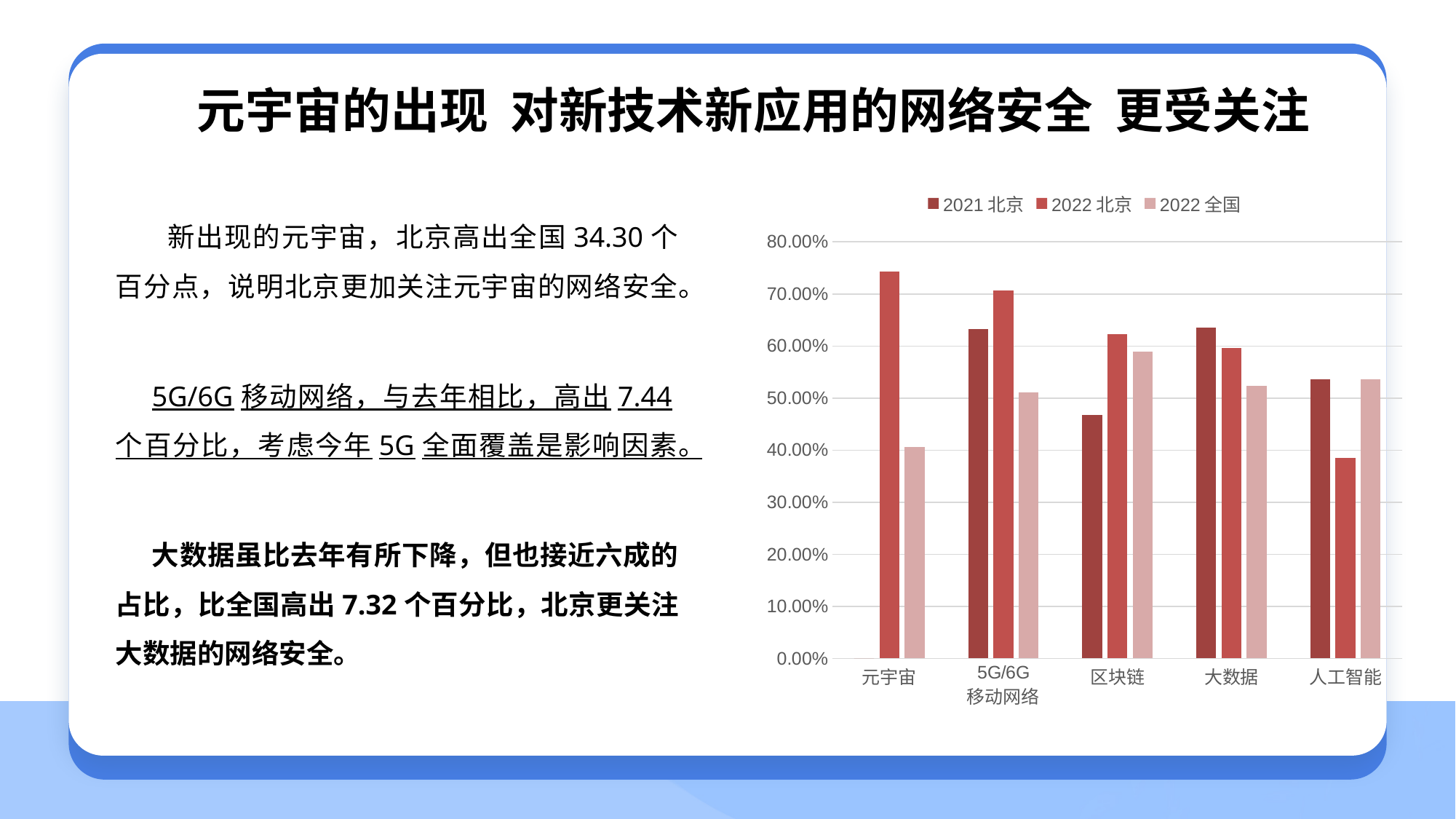
How many categories are shown on the x axis of the chart? 5 What kind of chart is shown on the slide? bar chart Is the 2022 北京 value for 元宇宙 greater or less than 70.00%? greater Which category has the lowest value for the 2022 全国 series? 元宇宙 Is the 2021 北京 value for 区块链 greater or less than 50.00%? less Which category has the highest value for the 2022 北京 series? 元宇宙 How many series does the chart legend list? 3 Is the 2022 北京 value for 人工智能 greater or less than 40.00%? less Which category has no bar for the 2021 北京 series? 元宇宙 For 大数据, which is larger: the 2021 北京 value or the 2022 北京 value? 2021 北京 Which category has the lowest value for the 2022 北京 series? 人工智能